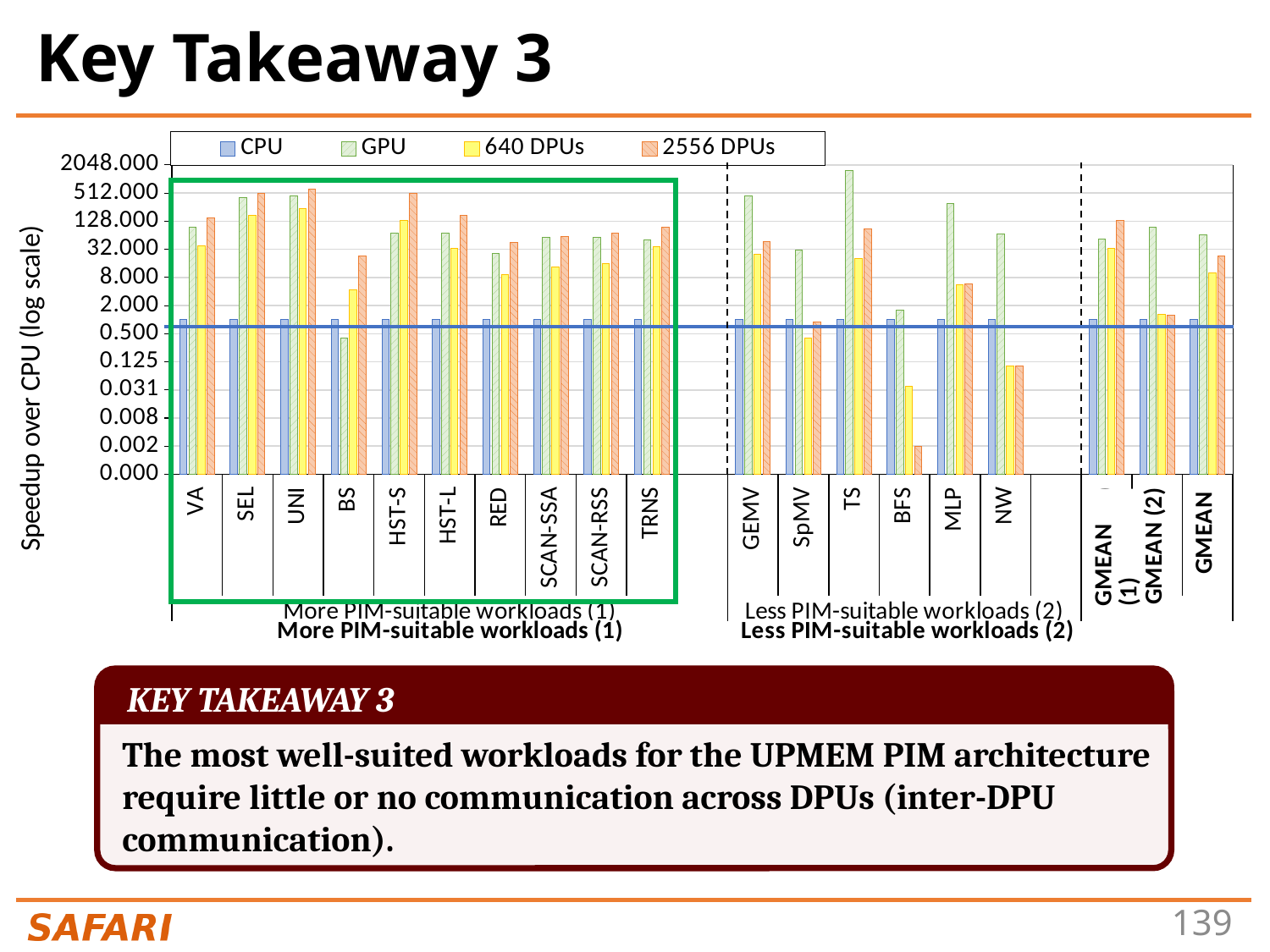
What is the label of the y axis? Speedup over CPU (log scale) Is the 2556 DPUs value for BFS greater or less than 0.008? less For BS, which is larger: the GPU value or the 2556 DPUs value? 2556 DPUs How many series does the legend list? 4 For BFS, which series has the lowest value? 2556 DPUs Is the GPU value for TS greater or less than 512.000? greater Which workload has the highest GPU speedup? TS How many workload categories are shown along the x axis, including the GMEAN entries? 19 Is the 2556 DPUs value for SEL greater or less than 128.000? greater For GEMV, which is larger: the GPU value or the 2556 DPUs value? GPU What kind of chart is shown on the slide? bar chart